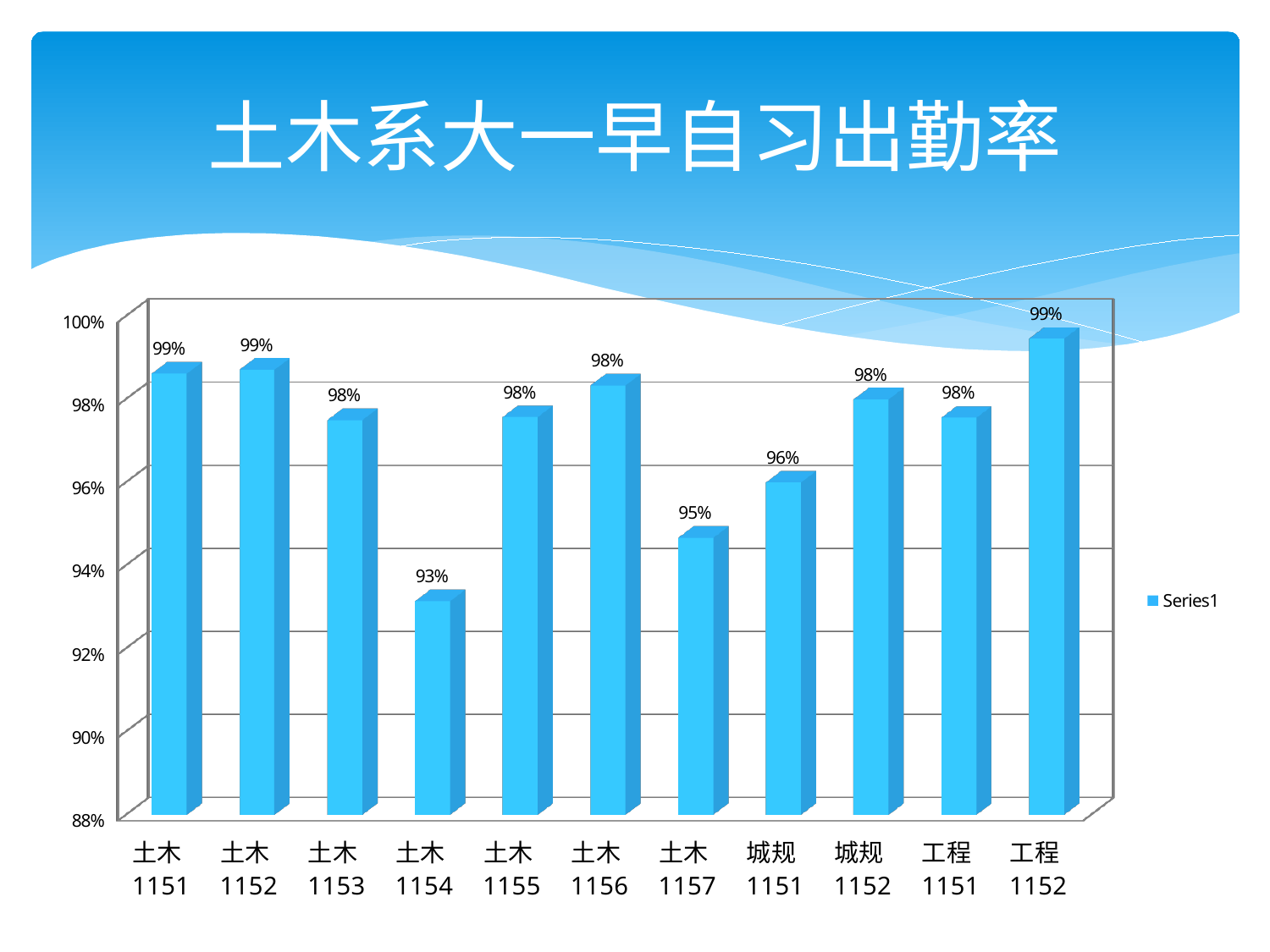
What is the difference between the values for 城规1152 and 城规1151? 2% Which is larger, the value for 土木1157 or the value for 城规1151? 城规1151 What is the value for 土木1154? 93% What is the value for 土木1157? 95% What is the value for 城规1151? 96% What kind of chart is shown on the slide? bar chart What is the difference between the values for 土木1151 and 土木1154? 6% What is the title of the slide? 土木系大一早自习出勤率 Which category has the lowest value? 土木1154 Is the value for 土木1154 greater or less than 94%? less What is the value for 工程1152? 99% How many categories are shown on the x axis? 11